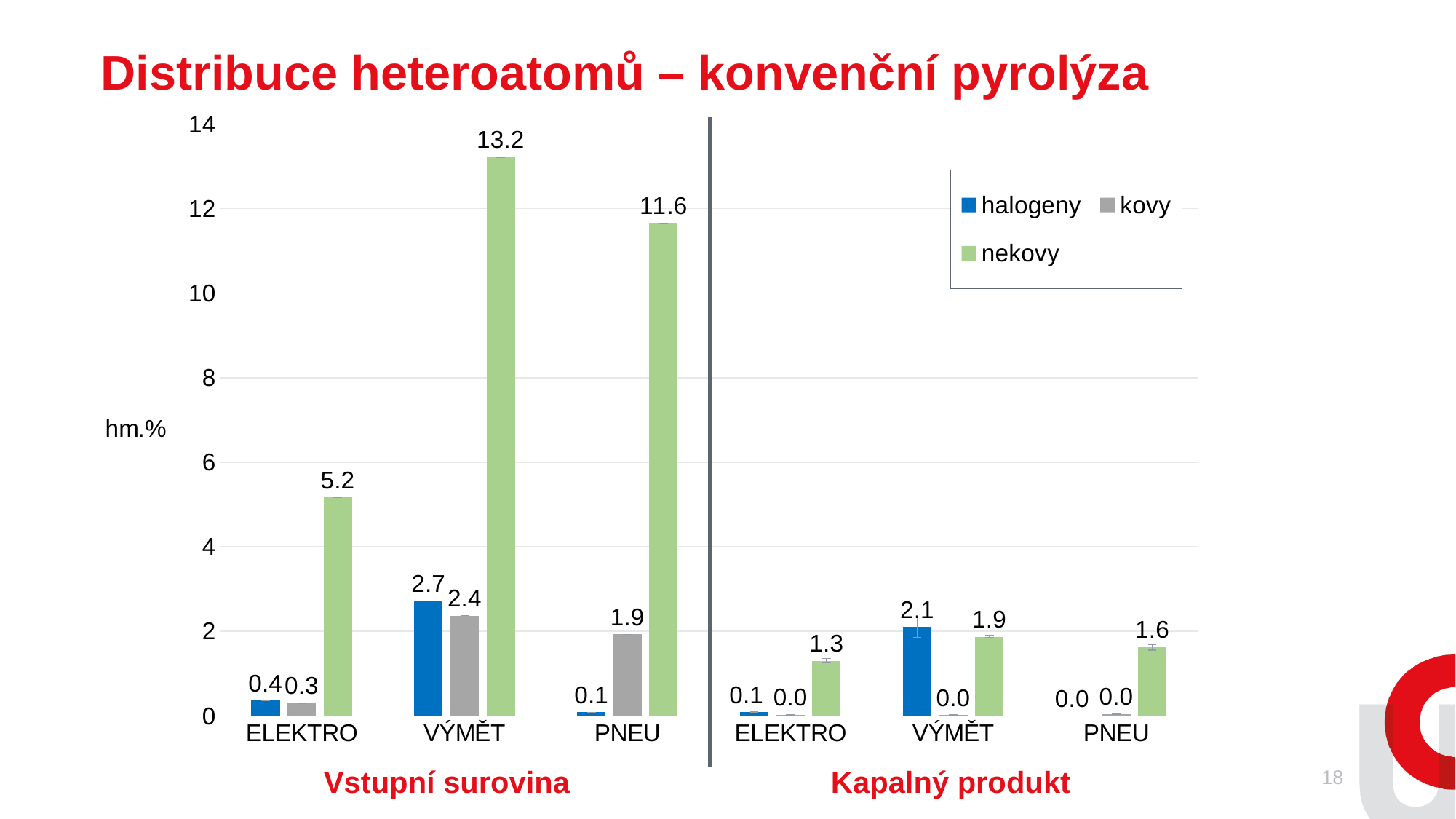
How many series does the legend list? 3 What is the value of nekovy for ELEKTRO in the Kapalný produkt section? 1.3 In the Kapalný produkt section, which is larger for VÝMĚT: halogeny or nekovy? halogeny What kind of chart is shown on the slide? bar chart What is the difference between the nekovy values for VÝMĚT and PNEU in the Vstupní surovina section? 1.6 What unit is shown on the vertical axis of the chart? hm.% Is the nekovy value for PNEU in the Vstupní surovina section greater or less than 10? greater Which category in the Vstupní surovina section has the lowest nekovy value? ELEKTRO Which category has the highest nekovy value across the whole chart? VÝMĚT (Vstupní surovina) What is the value of halogeny for VÝMĚT in the Kapalný produkt section? 2.1 What is the value of nekovy for VÝMĚT in the Vstupní surovina section? 13.2 What is the value of kovy for PNEU in the Vstupní surovina section? 1.9